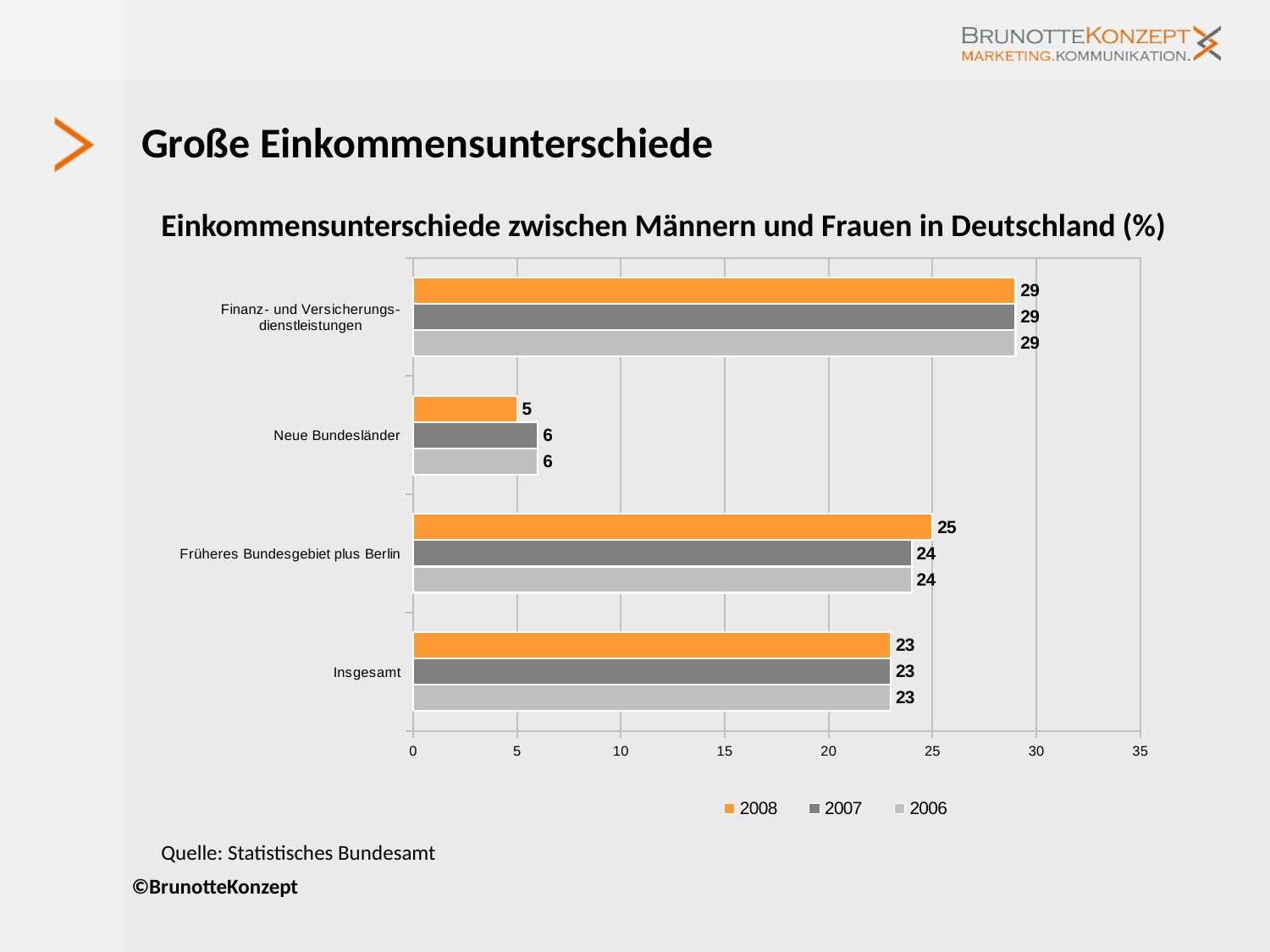
What is the 2008 value for Insgesamt? 23 How many series does the legend list? 3 What is the 2008 value for Neue Bundesländer? 5 What is the 2007 value for Früheres Bundesgebiet plus Berlin? 24 How many categories are shown on the chart? 4 Which category has the highest 2008 value? Finanz- und Versicherungsdienstleistungen What kind of chart is shown on the slide? Bar chart Which is larger for Früheres Bundesgebiet plus Berlin: the 2008 value or the 2006 value? 2008 Which category has the lowest 2007 value? Neue Bundesländer What is the difference between the 2008 values for Finanz- und Versicherungsdienstleistungen and Neue Bundesländer? 24 What is the 2006 value for Finanz- und Versicherungsdienstleistungen? 29 What is the title of the chart? Einkommensunterschiede zwischen Männern und Frauen in Deutschland (%)